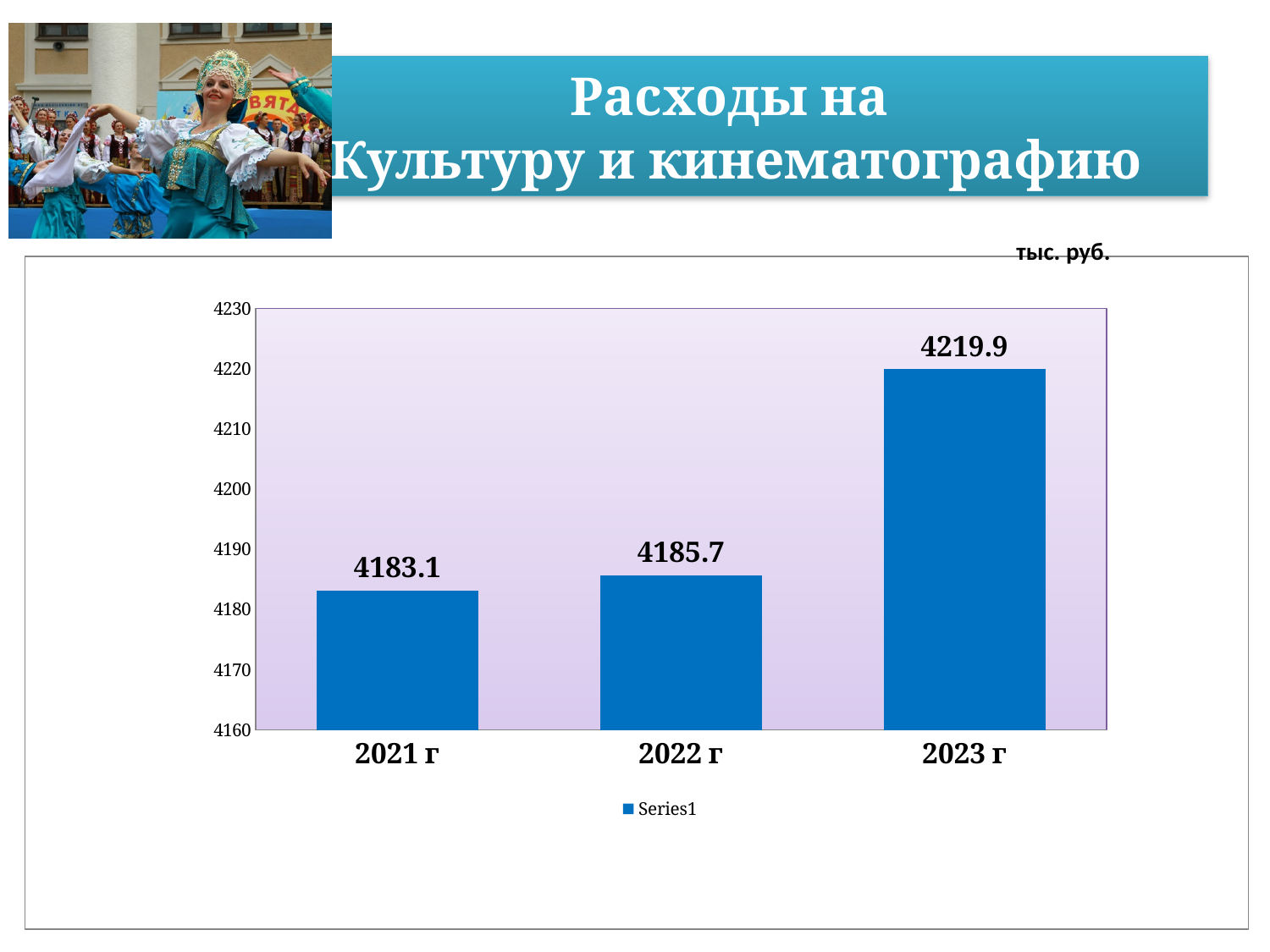
What is the value for 2021 г? 4183.1 Do the values rise or fall from 2021 г to 2023 г? rise Is the value for 2023 г greater or less than 4200? greater How many years are shown on the x axis? 3 What is the difference between the values for 2022 г and 2021 г? 2.6 Which year has the highest value? 2023 г What is the value for 2023 г? 4219.9 What kind of chart is shown on the slide? bar chart What is the difference between the values for 2023 г and 2022 г? 34.2 What is the value for 2022 г? 4185.7 Which is larger, the value for 2021 г or the value for 2023 г? 2023 г Which year has the lowest value? 2021 г